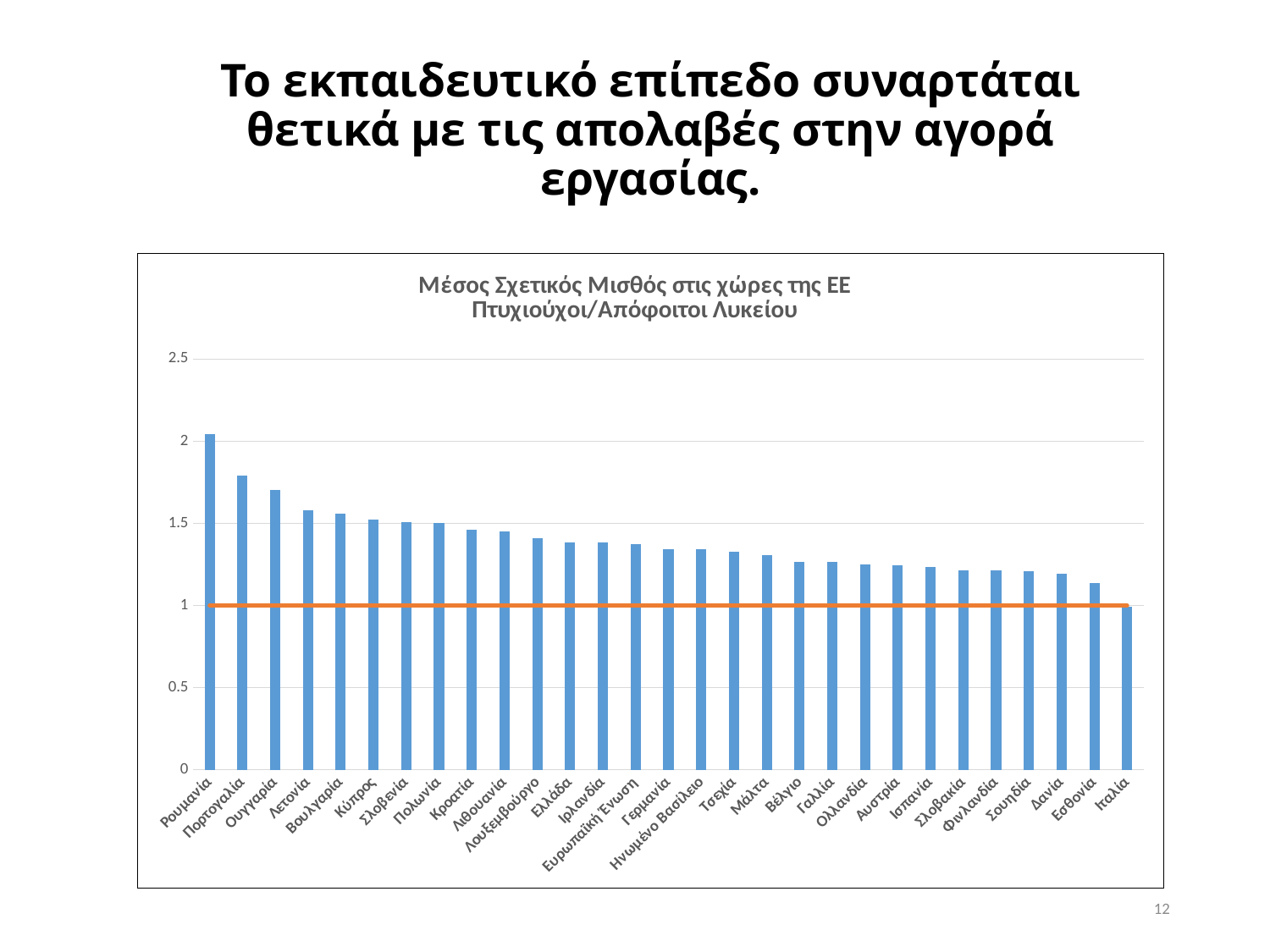
Is the value for Ελλάδα greater or less than 1.5? less Which country has the lowest value in the chart? Ιταλία Which has a larger value, Ρουμανία or Πορτογαλία? Ρουμανία How many countries/categories are shown on the x axis? 29 At what value on the y axis is the horizontal orange line drawn? 1 Is the value for Ρουμανία greater or less than 2? greater Is the value for Εσθονία greater or less than 1? greater Do the bar values rise or fall from left to right along the x axis? Fall Which has a larger value, Ουγγαρία or Λετονία? Ουγγαρία What kind of chart is shown on the slide? Bar chart Which country has the highest value in the chart? Ρουμανία